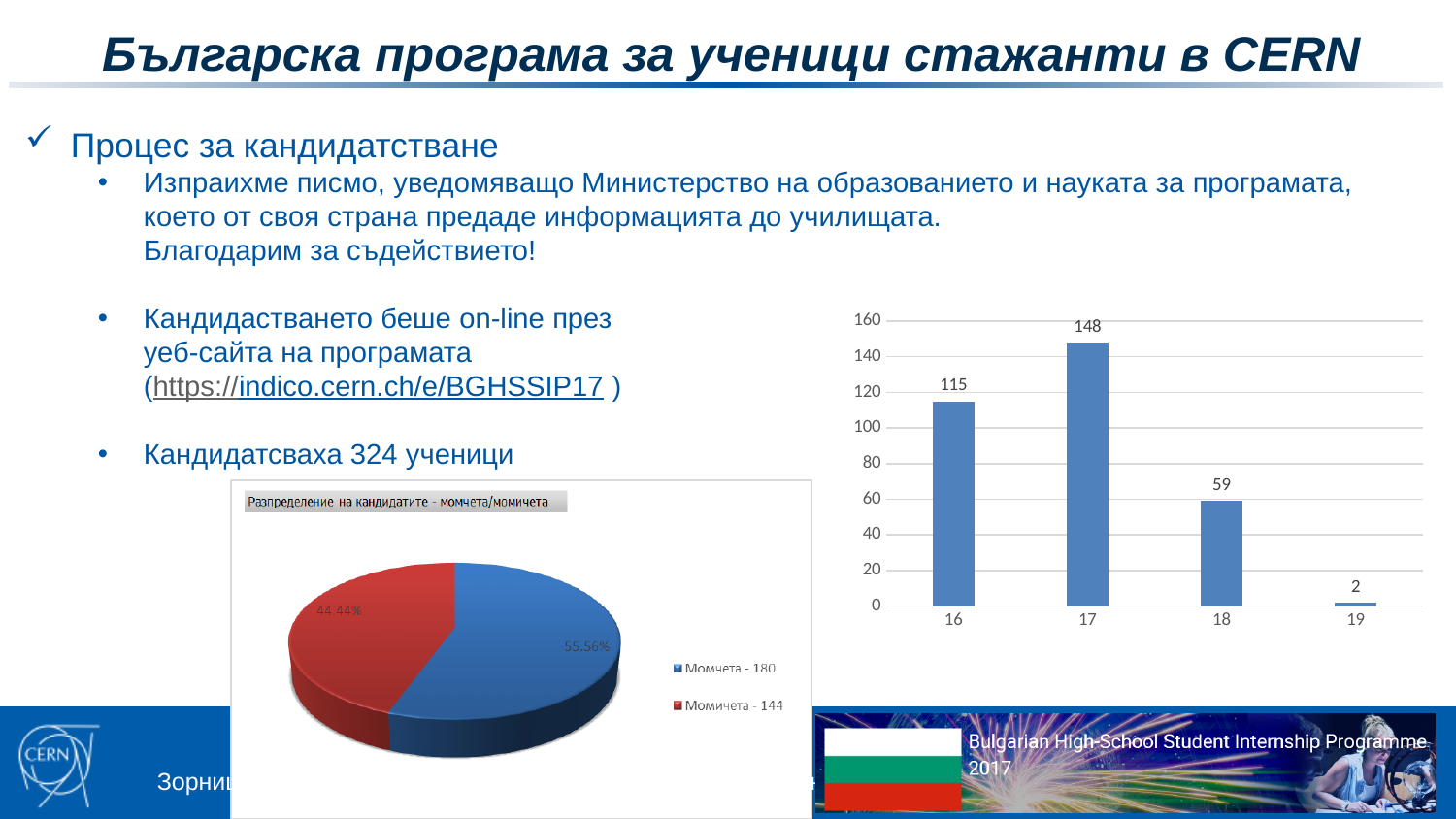
In the pie chart titled 'Разпределение на кандидатите - момчета/момичета', how many entries does the legend list? 2 In the bar chart on the right, what is the difference between the values for 17 and 16? 33 In the bar chart on the right, which category has the highest value? 17 In the pie chart titled 'Разпределение на кандидатите - момчета/момичета', what number is shown in the legend for Момичета? 144 In the bar chart on the right, what is the value for category 17? 148 In the pie chart titled 'Разпределение на кандидатите - момчета/момичета', what share does the red slice (Момичета) have? 44.44% In the pie chart titled 'Разпределение на кандидатите - момчета/момичета', what share does the blue slice (Момчета) have? 55.56% What kind of chart is the chart on the right of the slide? bar chart In the bar chart on the right, how many categories are shown on the x axis? 4 In the bar chart on the right, which category has the lowest value? 19 In the bar chart on the right, which is larger, the value for 16 or the value for 18? 16 In the bar chart on the right, what is the value for category 18? 59